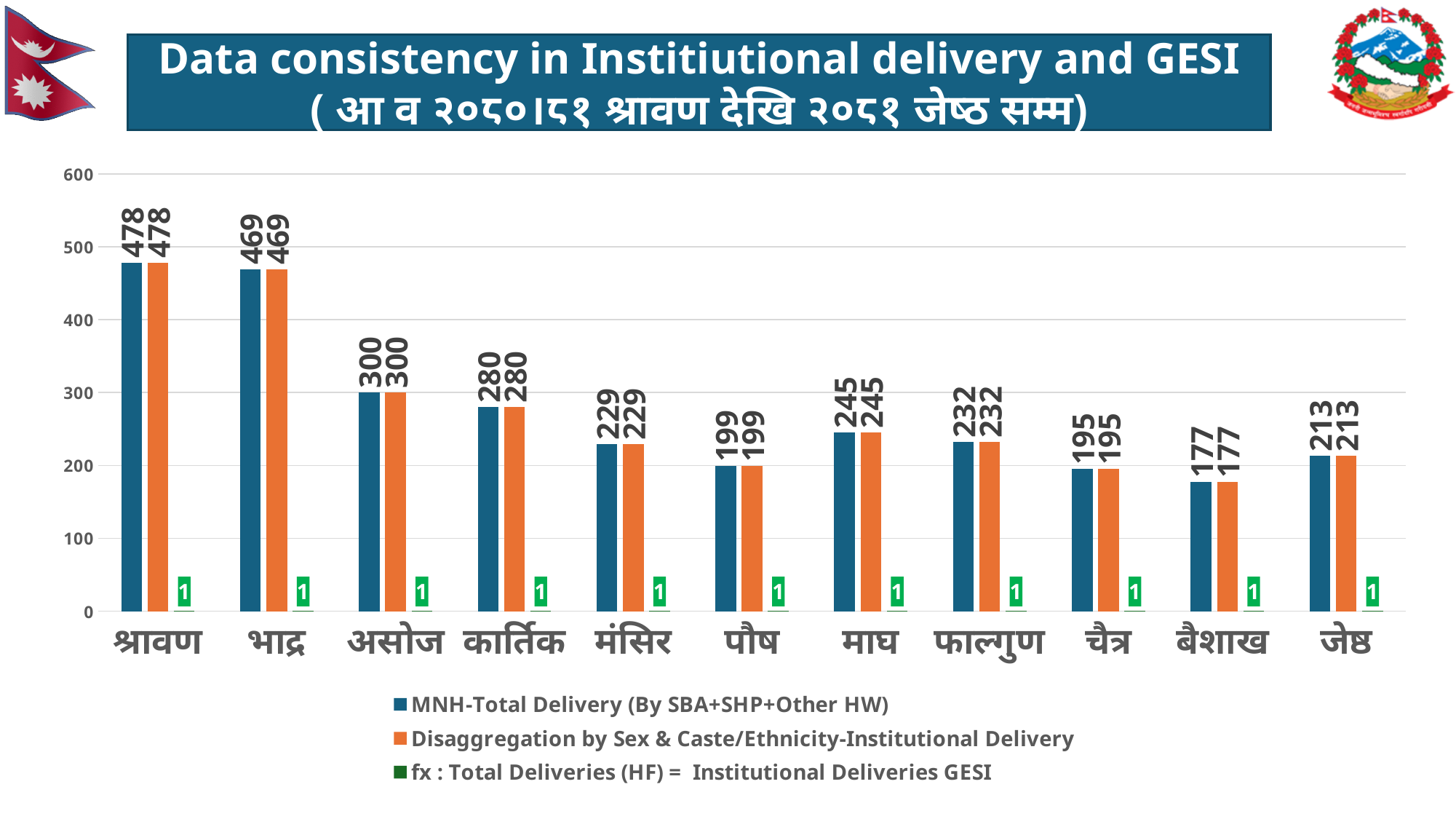
What is the Disaggregation by Sex & Caste/Ethnicity-Institutional Delivery value for बैशाख? 177 What value does the green series (fx : Total Deliveries (HF) = Institutional Deliveries GESI) show for each month? 1 What kind of chart is shown on the slide? bar chart Which month has the lowest MNH-Total Delivery value? बैशाख Which is larger, the MNH-Total Delivery value for माघ or for फाल्गुण? माघ What is the difference between the MNH-Total Delivery values for श्रावण and भाद्र? 9 How many series does the legend list? 3 How many months are shown on the x axis? 11 What is the MNH-Total Delivery value for माघ? 245 Which month has the highest MNH-Total Delivery value? श्रावण What is the MNH-Total Delivery value for श्रावण? 478 Is the MNH-Total Delivery value for असोज greater or less than 200? greater